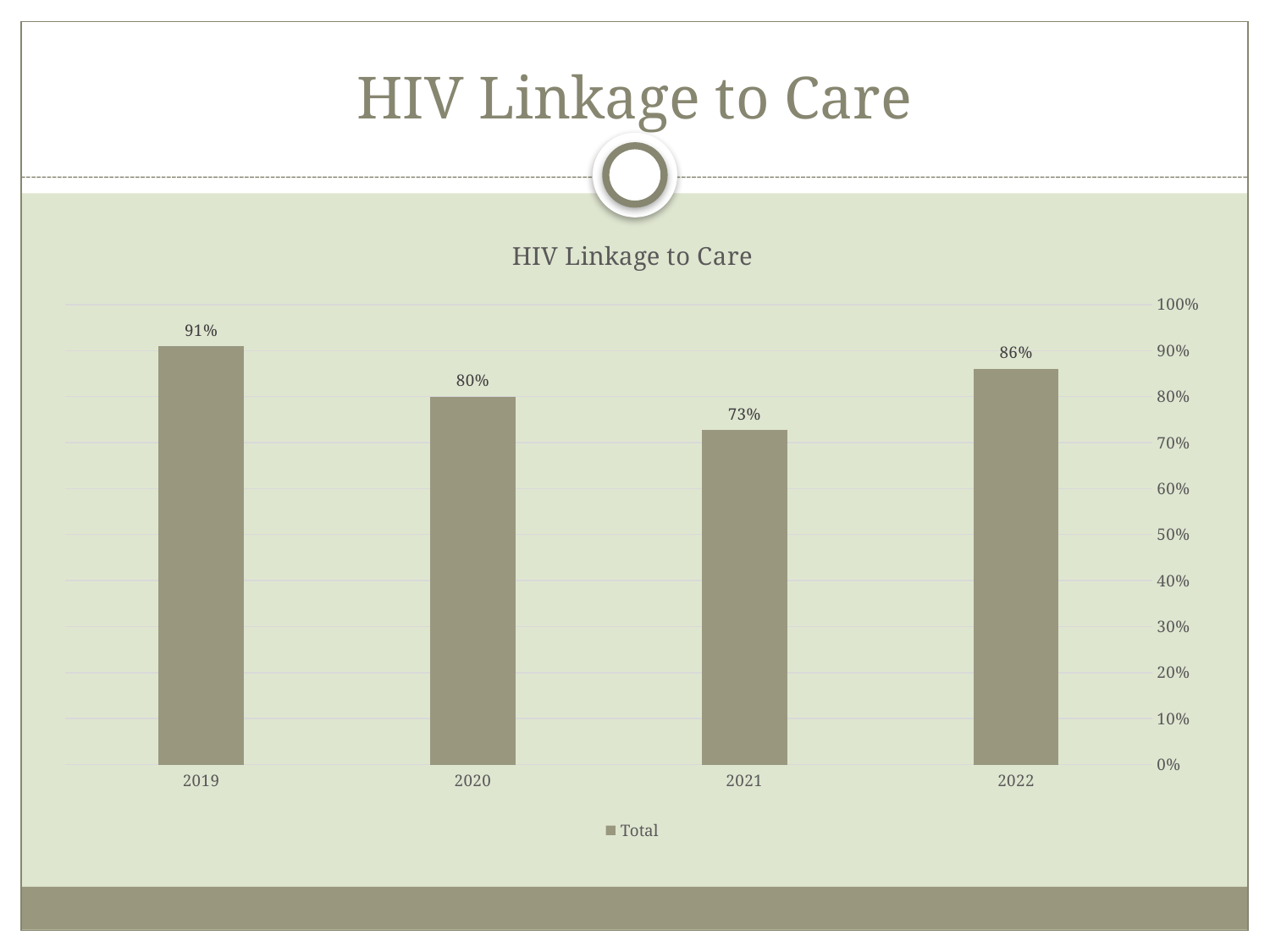
Which year has the lowest HIV linkage to care value? 2021 How many years are shown on the x axis? 4 What is the value shown for 2022? 86% What is the HIV linkage to care value for 2021? 73% What is the HIV linkage to care value for 2019? 91% What is the difference between the 2022 and 2020 values? 6% Which year has a larger value, 2020 or 2022? 2022 What is the name of the series listed in the legend? Total Which year has the highest HIV linkage to care value? 2019 How many series does the legend list? 1 What kind of chart is shown on the slide? Bar chart What is the difference between the 2019 and 2021 values? 18%